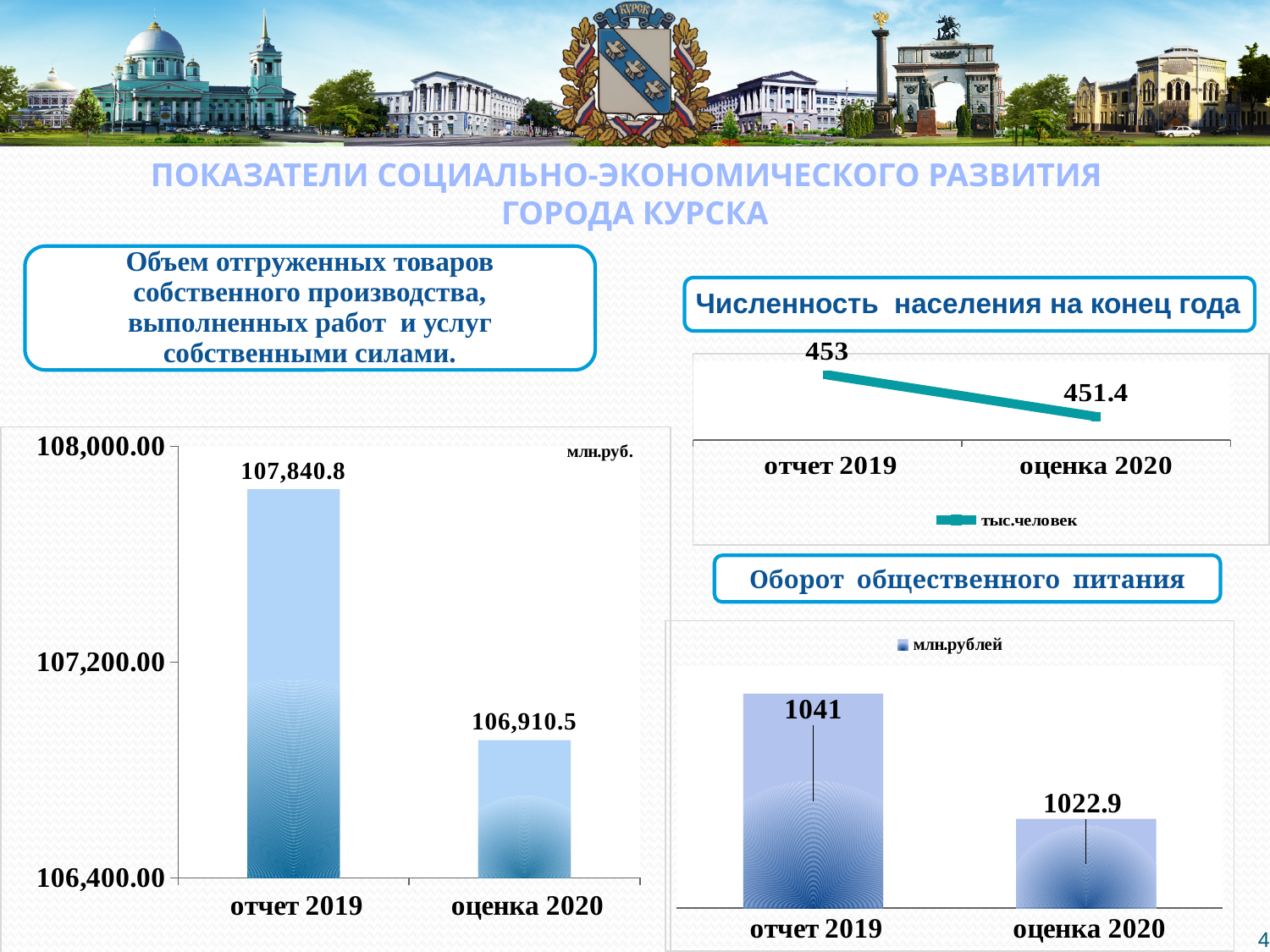
In the chart 'Объем отгруженных товаров собственного производства, выполненных работ и услуг собственными силами', what is the value for 'оценка 2020'? 106,910.5 In the chart 'Оборот общественного питания', what unit does the legend show? млн.рублей What kind of chart is 'Объем отгруженных товаров собственного производства, выполненных работ и услуг собственными силами'? bar chart What kind of chart is 'Численность населения на конец года'? line chart In the chart 'Оборот общественного питания', what is the difference between 'отчет 2019' and 'оценка 2020'? 18.1 In the chart 'Численность населения на конец года', what is the value for 'оценка 2020'? 451.4 In the chart 'Оборот общественного питания', what is the value for 'отчет 2019'? 1041 In the chart 'Объем отгруженных товаров собственного производства, выполненных работ и услуг собственными силами', do the values rise or fall from 'отчет 2019' to 'оценка 2020'? fall In the chart 'Численность населения на конец года', what is the value for 'отчет 2019'? 453 In the chart 'Объем отгруженных товаров собственного производства, выполненных работ и услуг собственными силами', what is the difference between 'отчет 2019' and 'оценка 2020'? 930.3 In the chart 'Численность населения на конец года', what is the difference between 'отчет 2019' and 'оценка 2020'? 1.6 In the chart 'Объем отгруженных товаров собственного производства, выполненных работ и услуг собственными силами', what is the value for 'отчет 2019'? 107,840.8